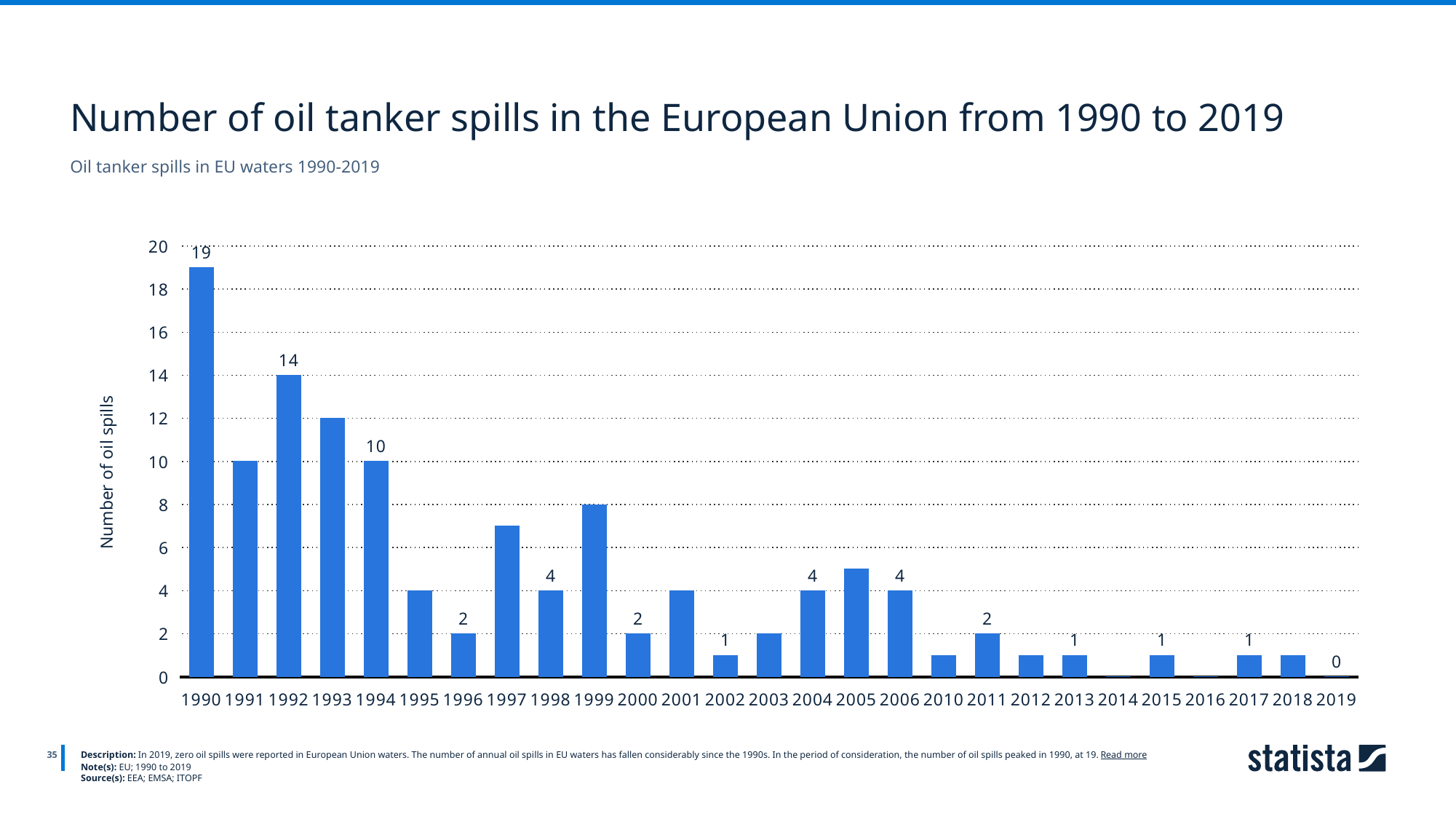
What is the number of oil spills shown for 1992? 14 What value is shown for 1994? 10 Is the value for 1997 greater or less than 6? greater What is the difference between the number of spills in 1990 and in 1992? 5 What is the number of oil spills shown for 2019? 0 How many years are shown on the x axis? 27 Which year had more oil spills, 1996 or 1998? 1998 Overall, do the values rise or fall from 1990 to 2019? Fall Is the value for 2005 greater or less than 4? greater What kind of chart is shown on the slide? Bar chart Which year has the highest number of oil tanker spills? 1990 How many oil tanker spills were recorded in 1990? 19